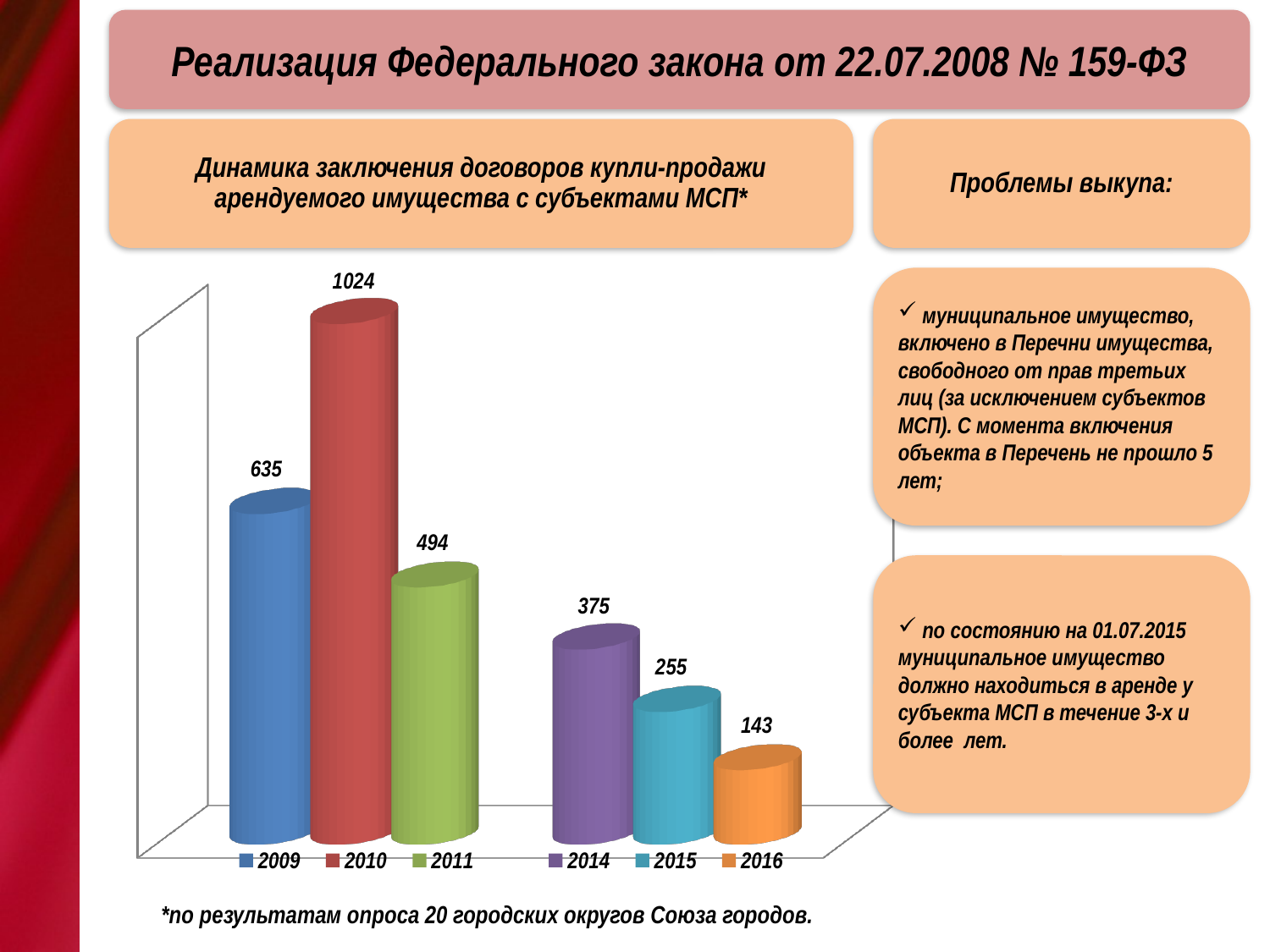
Which is larger, the value for 2011 or the value for 2014? 2011 What is the value for 2010? 1024 How many years are shown in the chart? 6 Which year has the lowest value? 2016 What kind of chart is shown on the slide? bar chart What is the difference between the values for 2010 and 2009? 389 How many entries does the legend list? 6 What is the difference between the values for 2015 and 2016? 112 Which year has the highest value? 2010 What is the value for 2014? 375 What is the value for 2016? 143 Do the values rise or fall from 2014 to 2016? fall